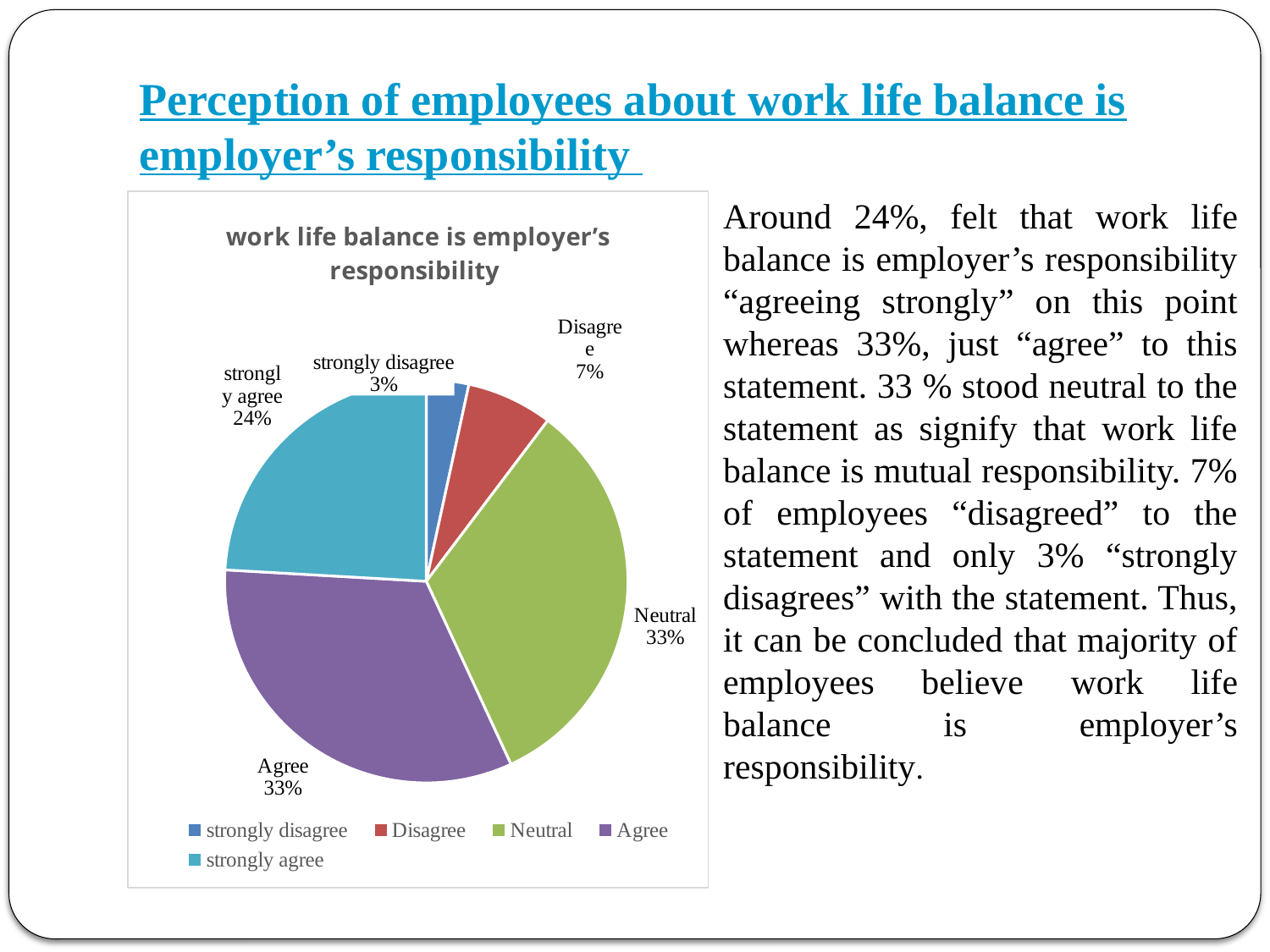
What is the chart's title? work life balance is employer's responsibility What share of the pie is labelled Disagree? 7% What share of the pie is labelled Neutral? 33% What kind of chart is shown on the slide? pie chart What share of the pie is labelled strongly disagree? 3% How many categories does the pie chart show? 5 What is the difference in percentage points between the strongly agree slice and the Disagree slice? 17 What is the combined share of the Agree and strongly agree slices? 57% Which category has the smallest slice of the pie? strongly disagree How many entries does the legend list? 5 Which slice is larger, strongly agree or Disagree? strongly agree